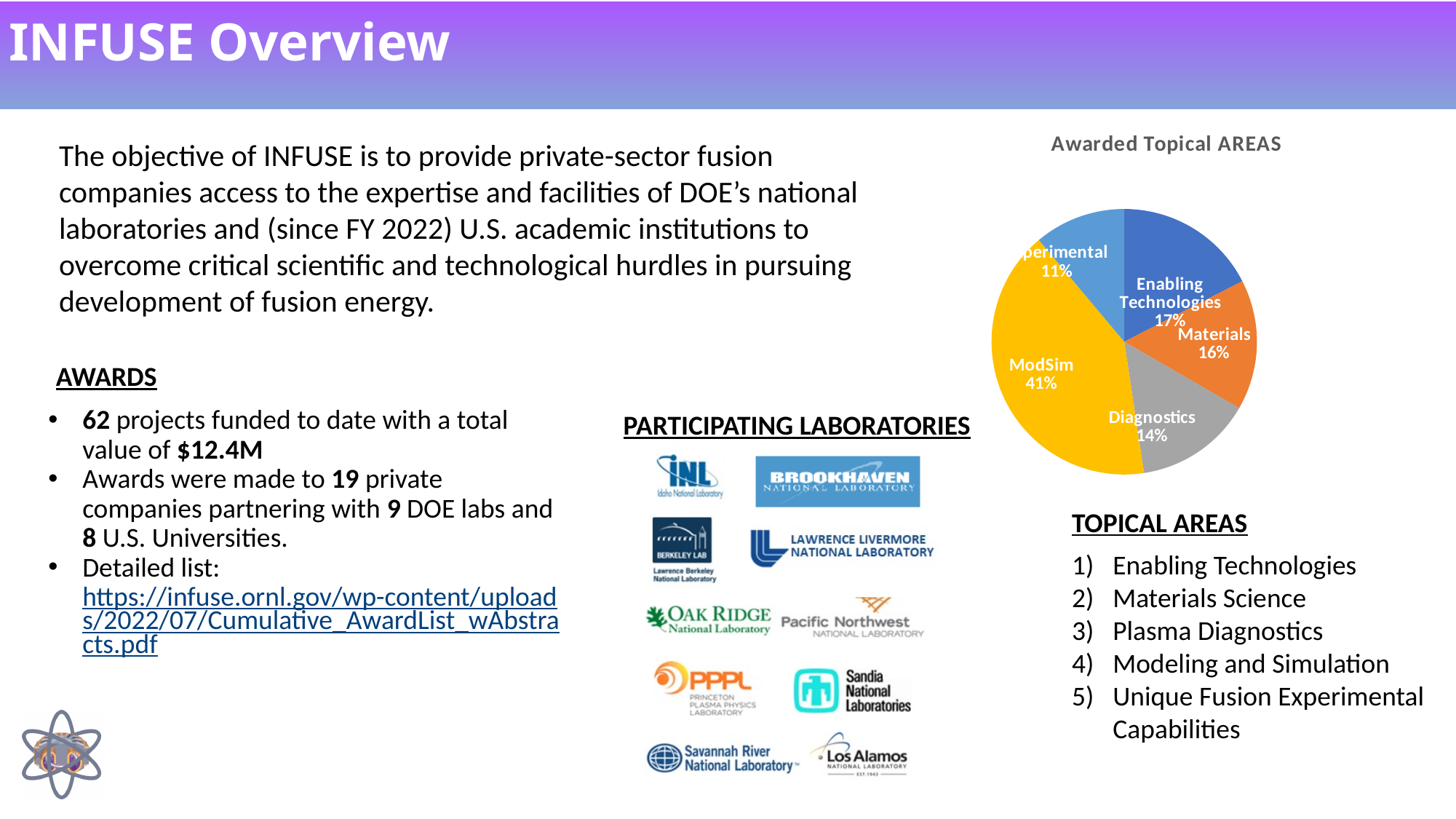
What is the title of the pie chart? Awarded Topical AREAS Which topical area has the largest share of the pie chart? ModSim What percentage of the pie chart is Enabling Technologies? 17% What colour is the ModSim slice in the pie chart? yellow Which has a larger share in the pie chart, Enabling Technologies or Materials? Enabling Technologies What type of chart is shown under the title "Awarded Topical AREAS"? pie chart What percentage of the pie chart is Materials? 16% Which topical area has the smallest share of the pie chart? Experimental What percentage of the pie chart is Diagnostics? 14% What percentage of the pie chart is ModSim? 41% What is the difference in percentage points between ModSim and Diagnostics in the pie chart? 27 How many slices does the pie chart have? 5